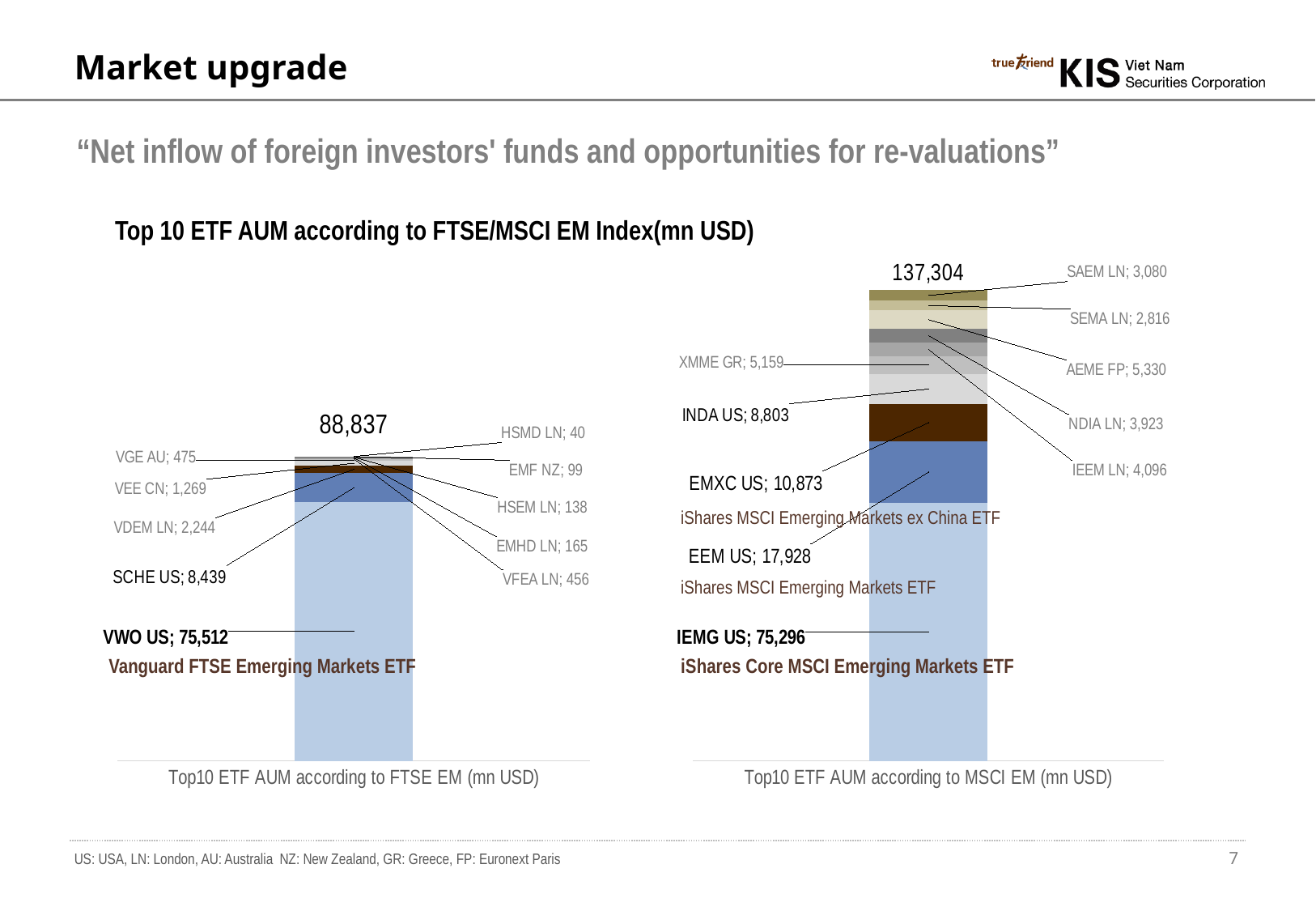
In the 'Top10 ETF AUM according to MSCI EM (mn USD)' chart, which has a larger AUM, AEME FP or XMME GR? AEME FP In the 'Top10 ETF AUM according to FTSE EM (mn USD)' chart, which ETF has the smallest AUM? HSMD LN What type of chart is used on the slide? Stacked bar chart In the 'Top10 ETF AUM according to MSCI EM (mn USD)' chart, what is the AUM of SEMA LN? 2,816 In the 'Top10 ETF AUM according to FTSE EM (mn USD)' chart, what is the difference between the AUM of SCHE US and VDEM LN? 6,195 In the 'Top10 ETF AUM according to FTSE EM (mn USD)' chart, what is the total of the stacked bar? 88,837 In the 'Top10 ETF AUM according to MSCI EM (mn USD)' chart, which ETF has the largest AUM? IEMG US In the 'Top10 ETF AUM according to MSCI EM (mn USD)' chart, what is the total of the stacked bar? 137,304 In the 'Top10 ETF AUM according to FTSE EM (mn USD)' chart, what is the AUM of VWO US? 75,512 In the 'Top10 ETF AUM according to FTSE EM (mn USD)' chart, how many ETFs are shown in the stacked bar? 10 In the 'Top10 ETF AUM according to MSCI EM (mn USD)' chart, what is the AUM of EEM US? 17,928 In the 'Top10 ETF AUM according to MSCI EM (mn USD)' chart, what is the difference between the AUM of EEM US and EMXC US? 7,055